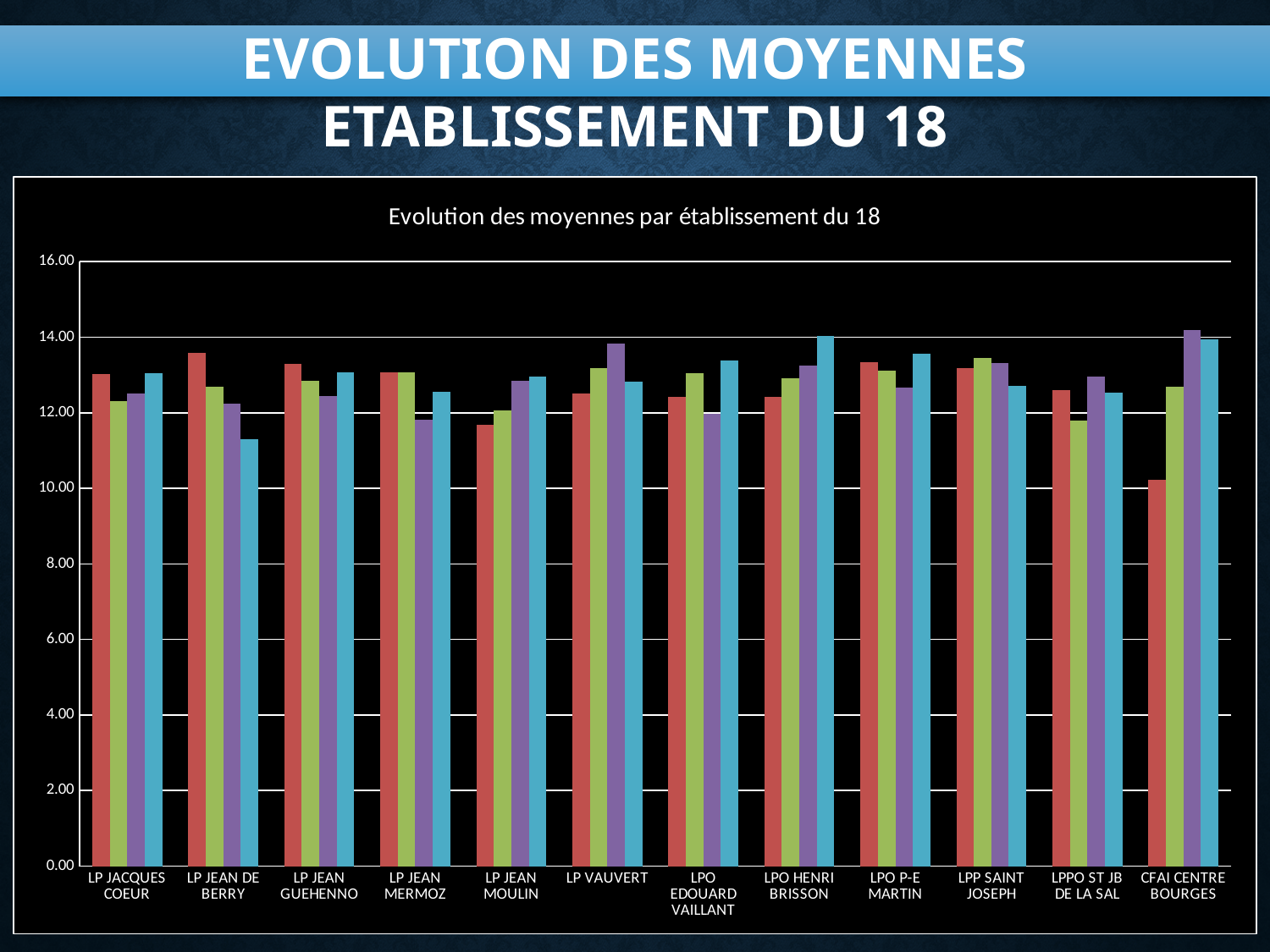
What is the title printed inside the chart area? Evolution des moyennes par établissement du 18 What is the highest value shown on the vertical axis of the chart? 16.00 Which is larger: the red bar for LP JEAN DE BERRY or the red bar for CFAI CENTRE BOURGES? LP JEAN DE BERRY How many bars are plotted for each establishment in the chart? 4 Is the value of the red bar for LP JEAN MOULIN greater or less than 12.00? less What kind of chart is shown on the slide? bar chart Is the value of the red bar for LP JEAN DE BERRY greater or less than 12.00? greater Which is larger: the blue bar for LPO HENRI BRISSON or the blue bar for LP JEAN DE BERRY? LPO HENRI BRISSON Is the value of the red bar for CFAI CENTRE BOURGES greater or less than 12.00? less Which establishment has the lowest red bar in the chart? CFAI CENTRE BOURGES How many establishments (categories) are shown on the x axis of the chart? 12